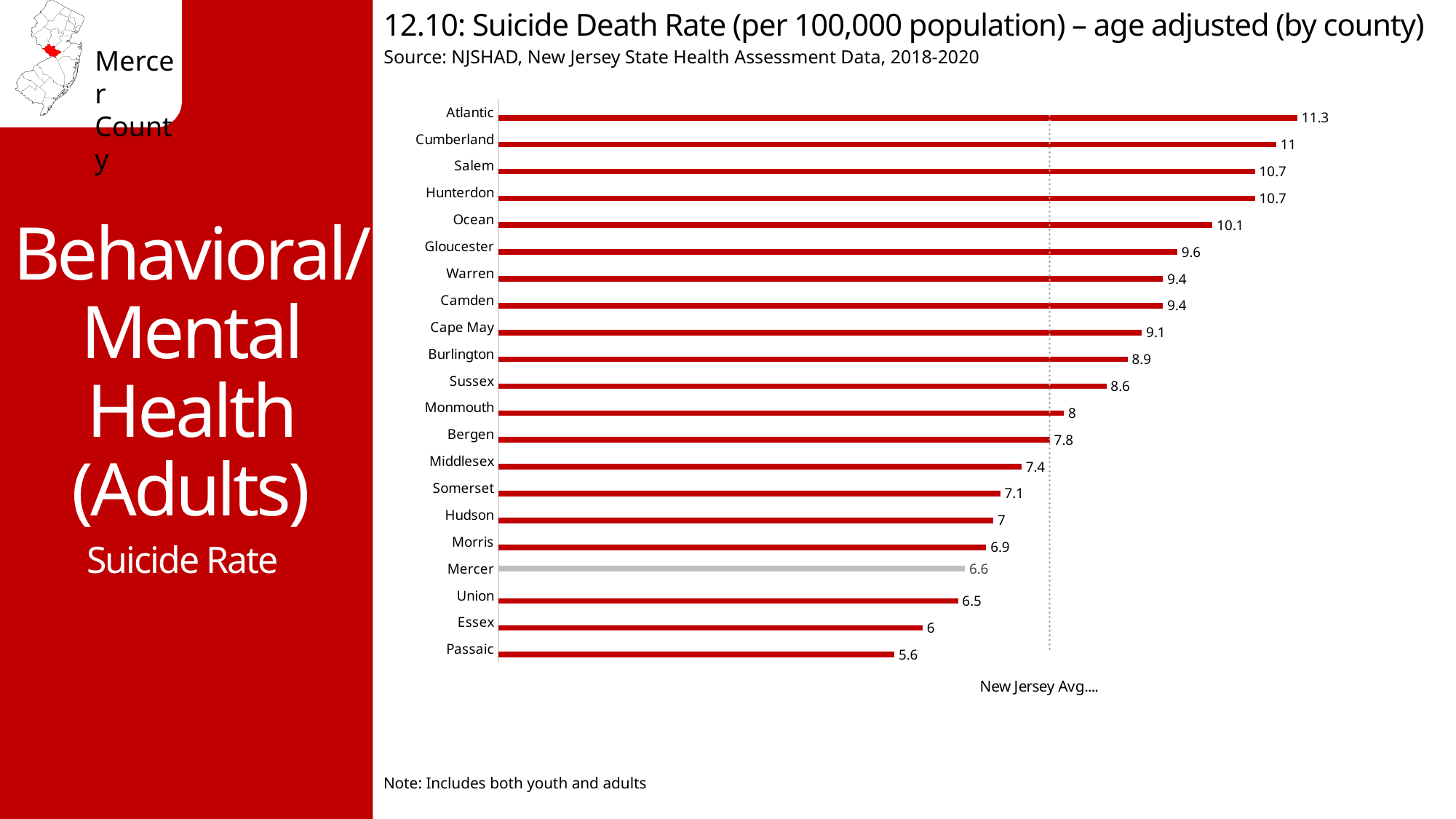
Which county has a higher suicide death rate, Gloucester or Bergen? Gloucester What is the difference between the suicide death rates of Ocean and Essex counties? 4.1 Which county has the lowest suicide death rate? Passaic How many counties are shown in the chart? 21 Which county has the highest suicide death rate? Atlantic Which county's bar is shown in grey instead of red? Mercer What is the difference between the suicide death rates of Atlantic and Mercer counties? 4.7 What is the suicide death rate for Passaic County? 5.6 What is the suicide death rate for Atlantic County? 11.3 What is the suicide death rate for Mercer County? 6.6 What type of chart is used to show the suicide death rates? Bar chart Which county has a higher suicide death rate, Union or Sussex? Sussex